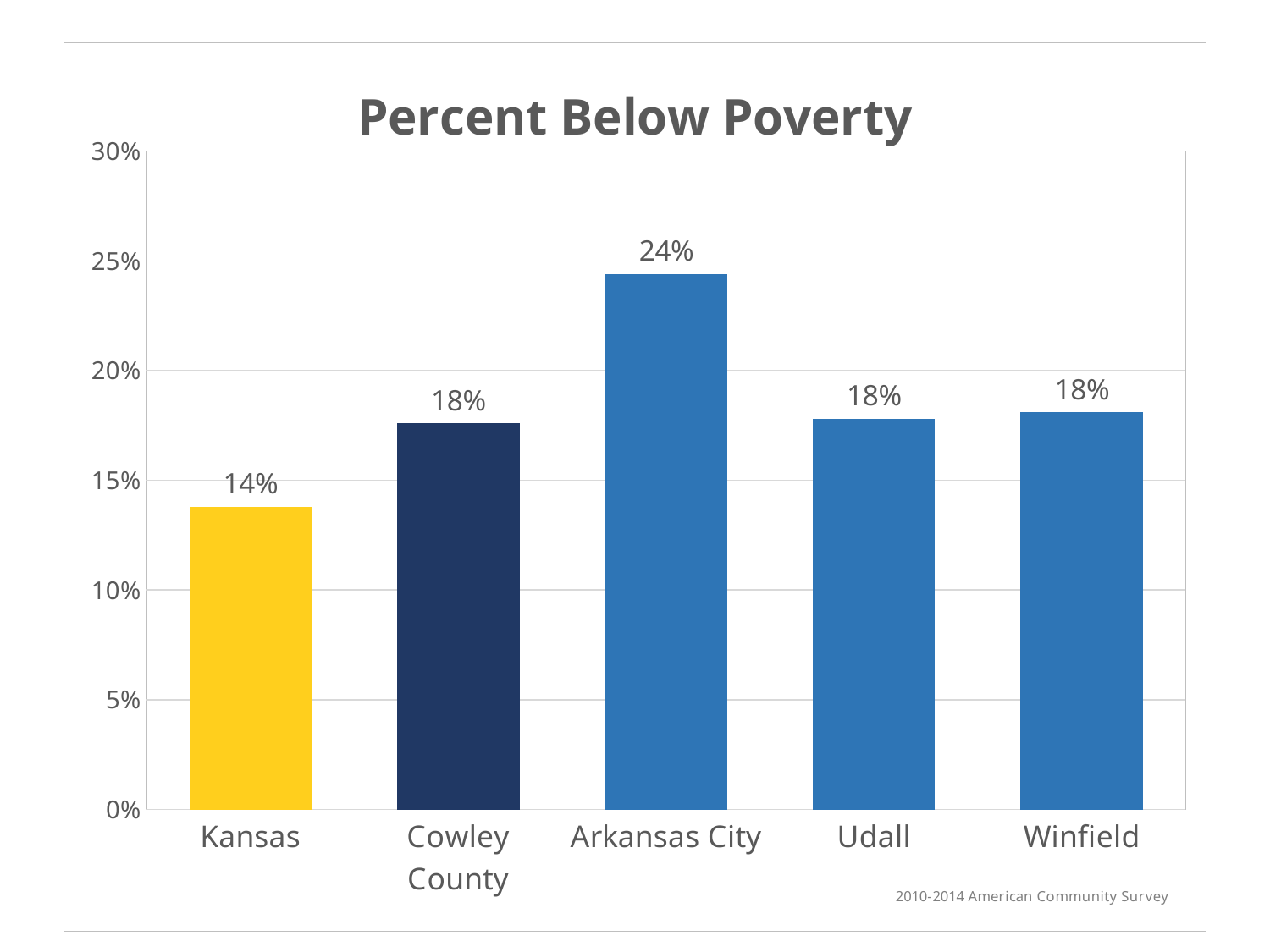
What is the value for Cowley County? 18% Which is larger, the value for Arkansas City or the value for Winfield? Arkansas City What kind of chart is shown on the slide? bar chart Which category has the lowest percent below poverty? Kansas What is the value for Arkansas City? 24% What is the value for Kansas? 14% Is the value for Arkansas City greater or less than 20%? greater Which category has the highest percent below poverty? Arkansas City What is the difference between the values for Arkansas City and Kansas? 10% How many categories are shown on the chart? 5 What is the title of the chart? Percent Below Poverty What is the value for Udall? 18%